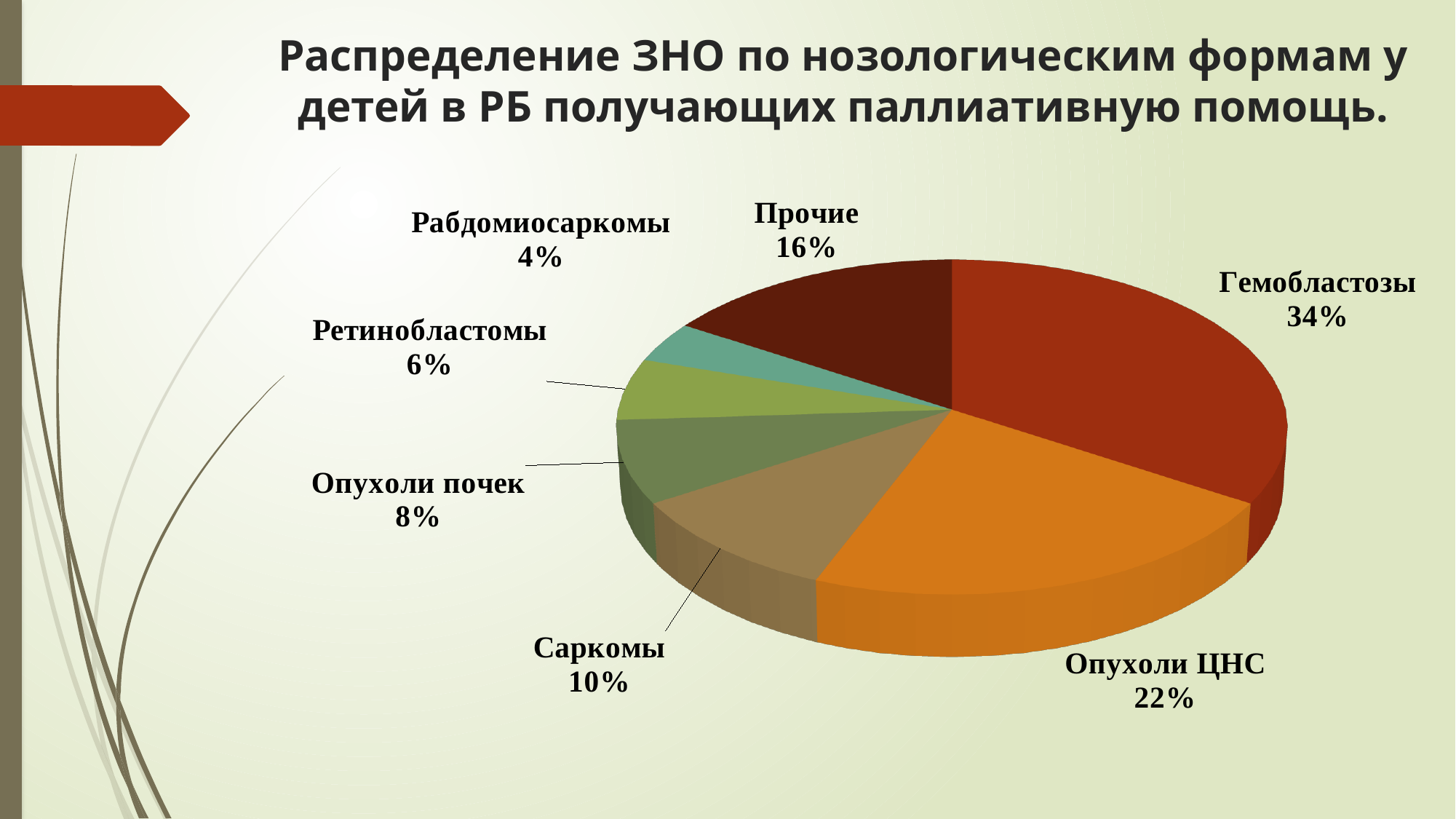
What is the value shown for Опухоли ЦНС? 22% What kind of chart is shown on the slide? Pie chart How many categories are shown in the pie chart? 7 Which category has the largest slice of the pie? Гемобластозы What is the value shown for Саркомы? 10% What share of the pie does Гемобластозы have? 34% What is the difference between the shares of Гемобластозы and Опухоли ЦНС? 12% Which category has the smallest slice of the pie? Рабдомиосаркомы What is the difference between the shares of Прочие and Саркомы? 6% Which is larger, the share for Опухоли почек or the share for Ретинобластомы? Опухоли почек What is the title of the chart on the slide? Распределение ЗНО по нозологическим формам у детей в РБ получающих паллиативную помощь. What is the value shown for Прочие? 16%